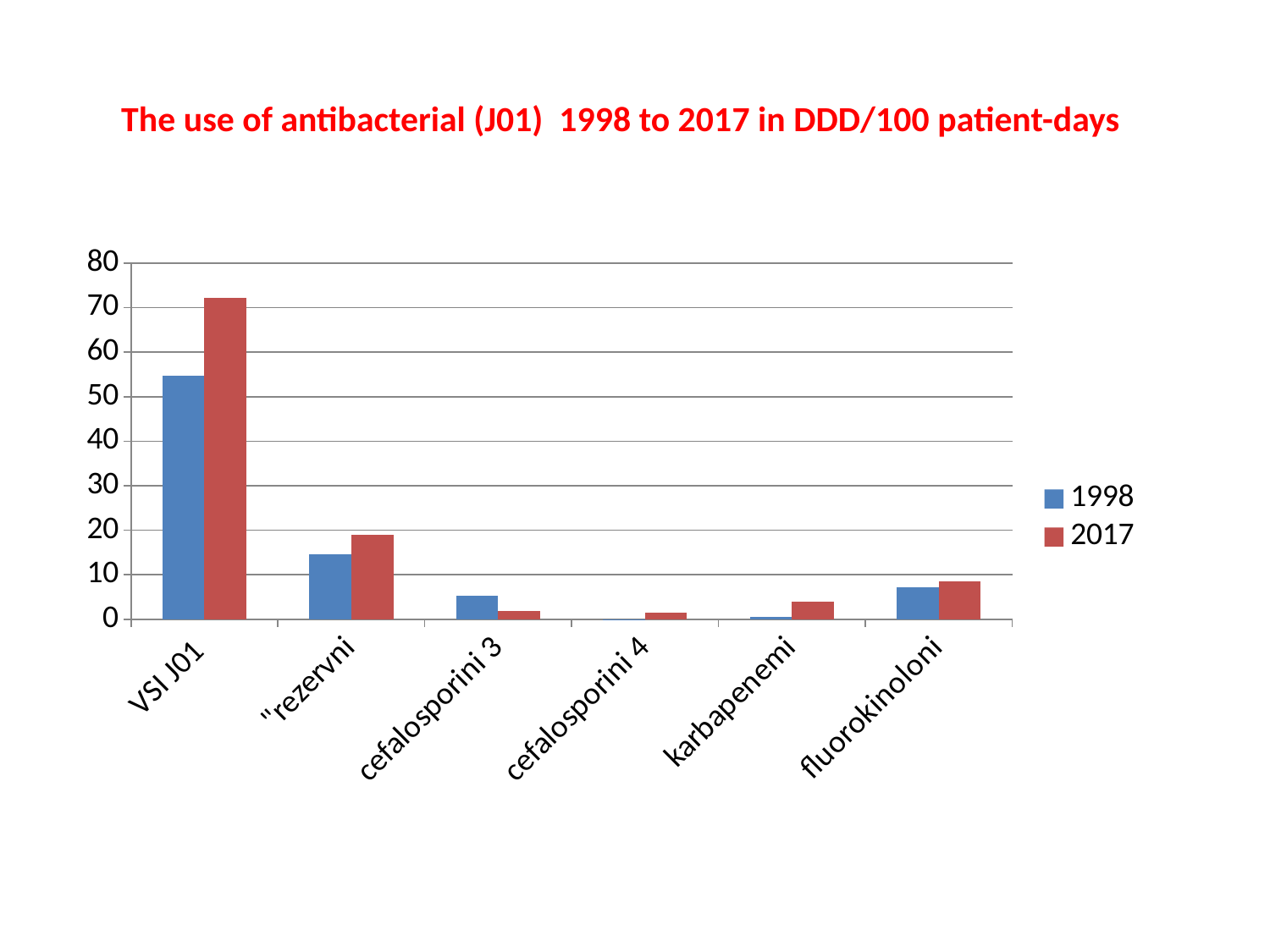
Is the 2017 value for rezervni greater or less than 10? greater For karbapenemi, which year has the larger value, 1998 or 2017? 2017 How many categories are shown on the x axis? 6 For VSI J01, which year has the larger value, 1998 or 2017? 2017 What kind of chart is shown on the slide? bar chart Is the 1998 value for VSI J01 greater or less than 50? greater How many series does the legend list? 2 Is the 2017 value for VSI J01 greater or less than 60? greater For cefalosporini 3, which year has the larger value, 1998 or 2017? 1998 Which category has the highest value for 1998? VSI J01 Which category has the highest value for 2017? VSI J01 What are the two entries listed in the legend? 1998 and 2017